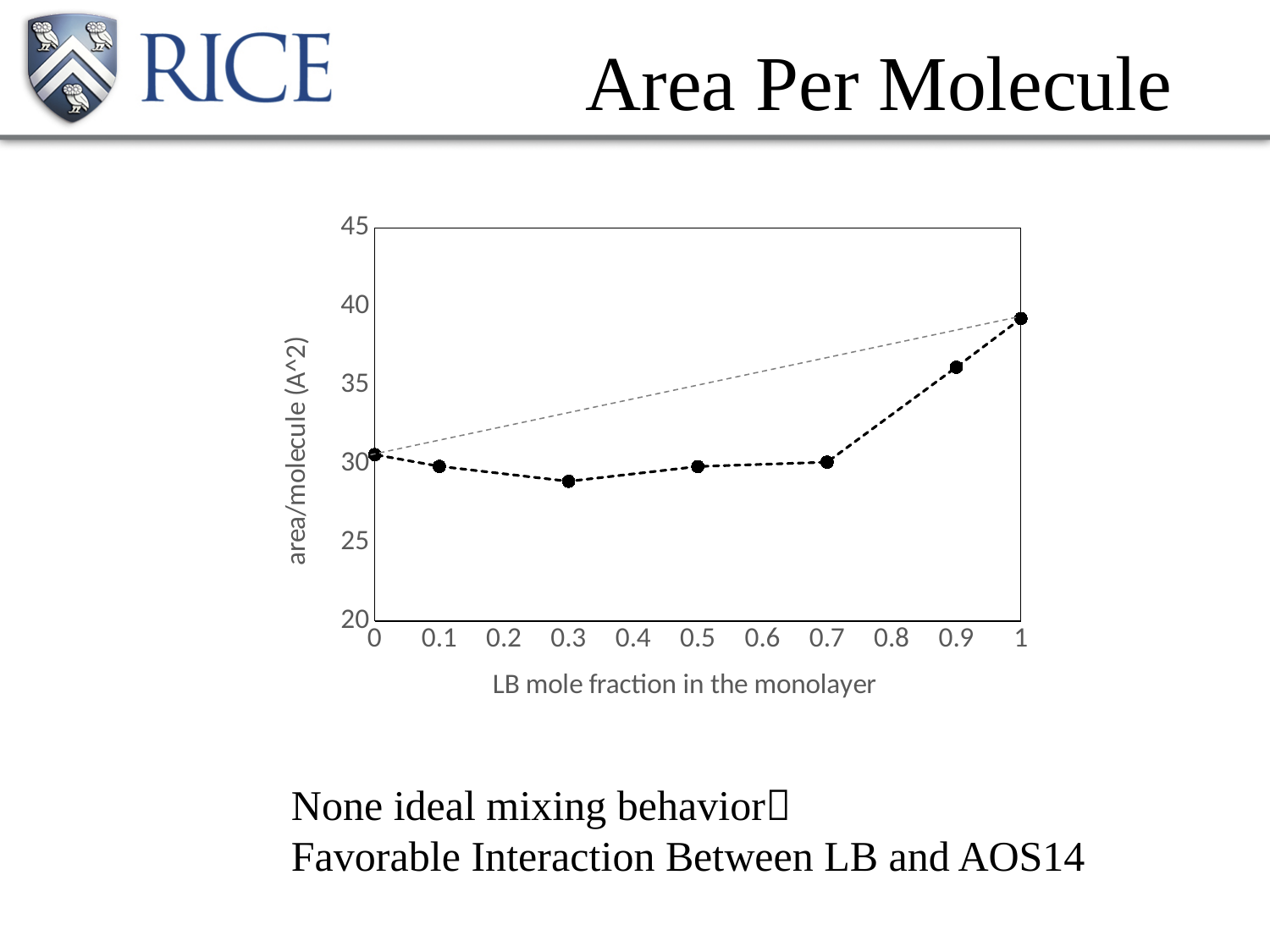
Is the area per molecule at LB mole fraction 0.3 greater or less than 30? less Is the area per molecule at LB mole fraction 1 greater or less than 35? greater Is the area per molecule at LB mole fraction 0.7 greater or less than 35? less At which LB mole fraction is the area per molecule lowest? 0.3 What is the label of the x axis? LB mole fraction in the monolayer How many data points are plotted on the chart? 7 At which LB mole fraction is the area per molecule highest? 1 Does the area per molecule rise or fall as the LB mole fraction goes from 0.7 to 1? rise What kind of chart is shown on the slide? line chart What is the label of the y axis? area/molecule (A^2) Which has the larger area per molecule: LB mole fraction 0.9 or 0.5? 0.9